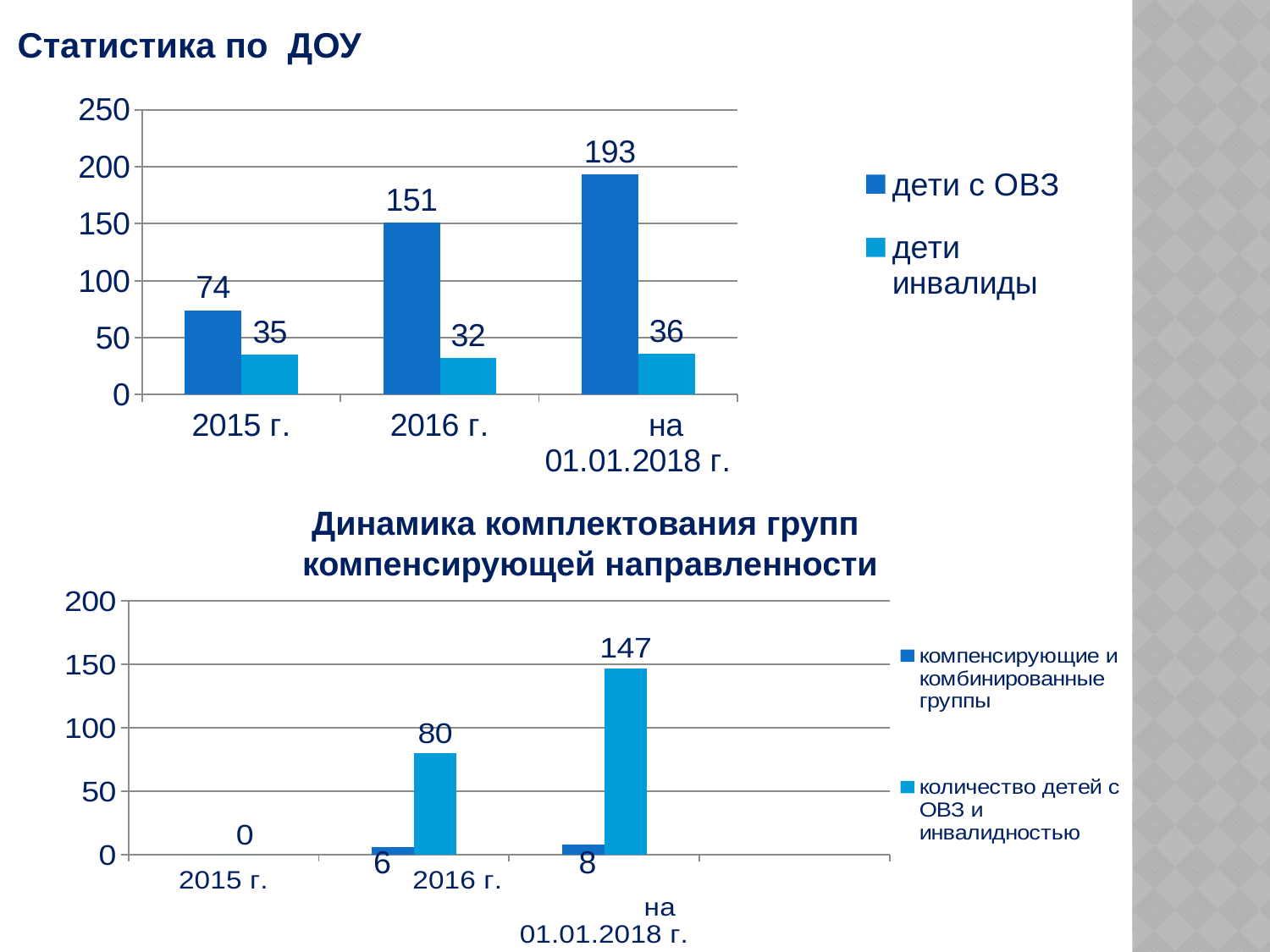
In the top chart, how many series does the legend list? 2 What kind of chart is the bottom chart on the slide? bar chart In the chart titled 'Динамика комплектования групп компенсирующей направленности', what is the value for компенсирующие и комбинированные группы on 01.01.2018 г.? 8 In the top chart, do the values for дети с ОВЗ rise or fall from 2015 г. to 01.01.2018 г.? rise In the chart titled 'Динамика комплектования групп компенсирующей направленности', what is the value for количество детей с ОВЗ и инвалидностью in 2016 г.? 80 In the chart titled 'Динамика комплектования групп компенсирующей направленности', what is the difference between количество детей с ОВЗ и инвалидностью on 01.01.2018 г. and in 2016 г.? 67 In the top chart, what is the value for дети инвалиды in 2015 г.? 35 In the top chart, which category has the lowest value for дети инвалиды? 2016 г. How many categories are shown on the x axis of the top chart? 3 In the top chart, what is the difference between дети с ОВЗ and дети инвалиды on 01.01.2018 г.? 157 In the top chart, what is the value for дети с ОВЗ in 2016 г.? 151 In the top chart, which category has the highest value for дети с ОВЗ? на 01.01.2018 г.